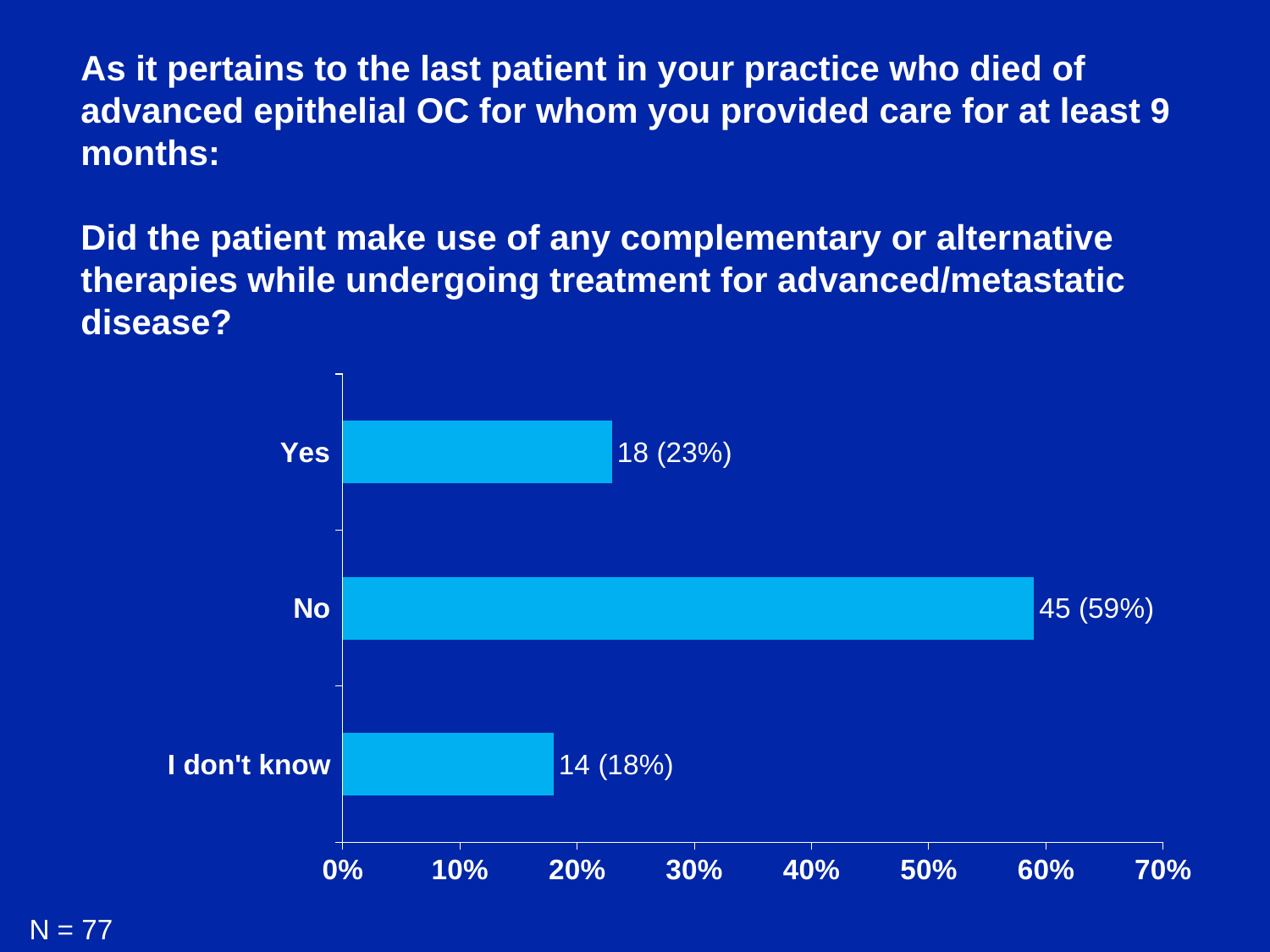
What is the sample size (N) stated on the slide? N = 77 Is the value for "No" greater or less than 50%? greater What is the data label shown for the "No" bar? 45 (59%) How many response categories are shown in the chart? 3 What is the data label shown for the "I don't know" bar? 14 (18%) What kind of chart is shown on the slide? Bar chart Which response category has the lowest value? I don't know How many more respondents answered "No" than "Yes"? 27 Which response category has the highest value? No What is the difference in percentage points between "Yes" and "I don't know"? 5% What is the data label shown for the "Yes" bar? 18 (23%) Which is larger, the value for "Yes" or the value for "I don't know"? Yes